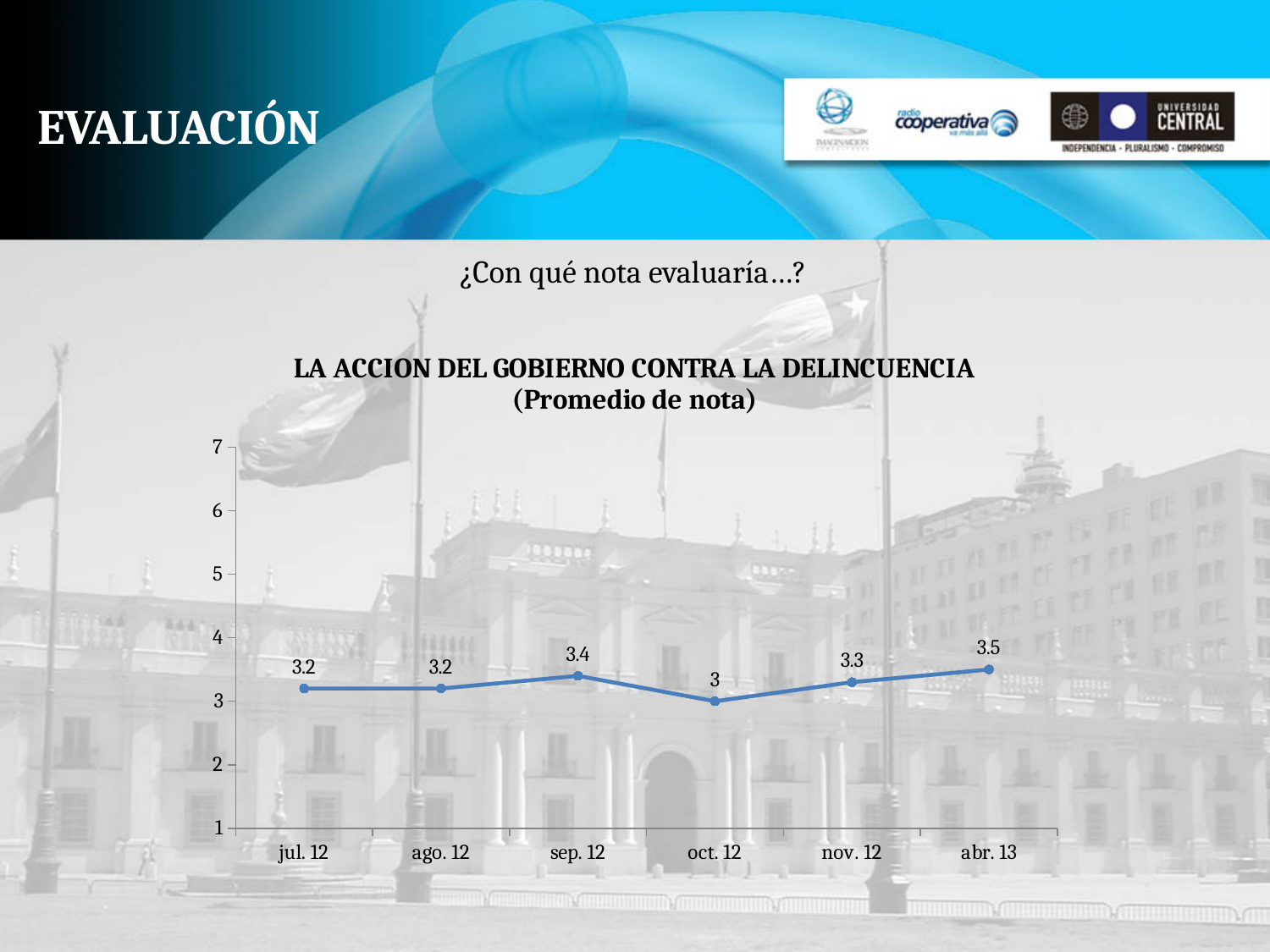
Which is larger, the value for sep. 12 or the value for nov. 12? sep. 12 What is the title of the chart? LA ACCION DEL GOBIERNO CONTRA LA DELINCUENCIA (Promedio de nota) Which month has the highest value? abr. 13 What is the value for oct. 12? 3 What is the value for jul. 12? 3.2 What is the value for sep. 12? 3.4 Is the value for nov. 12 greater or less than 4? less How many data points are plotted on the chart? 6 Which month has the lowest value? oct. 12 What kind of chart is shown on the slide? line chart What is the difference between the values for abr. 13 and oct. 12? 0.5 What is the value for abr. 13? 3.5